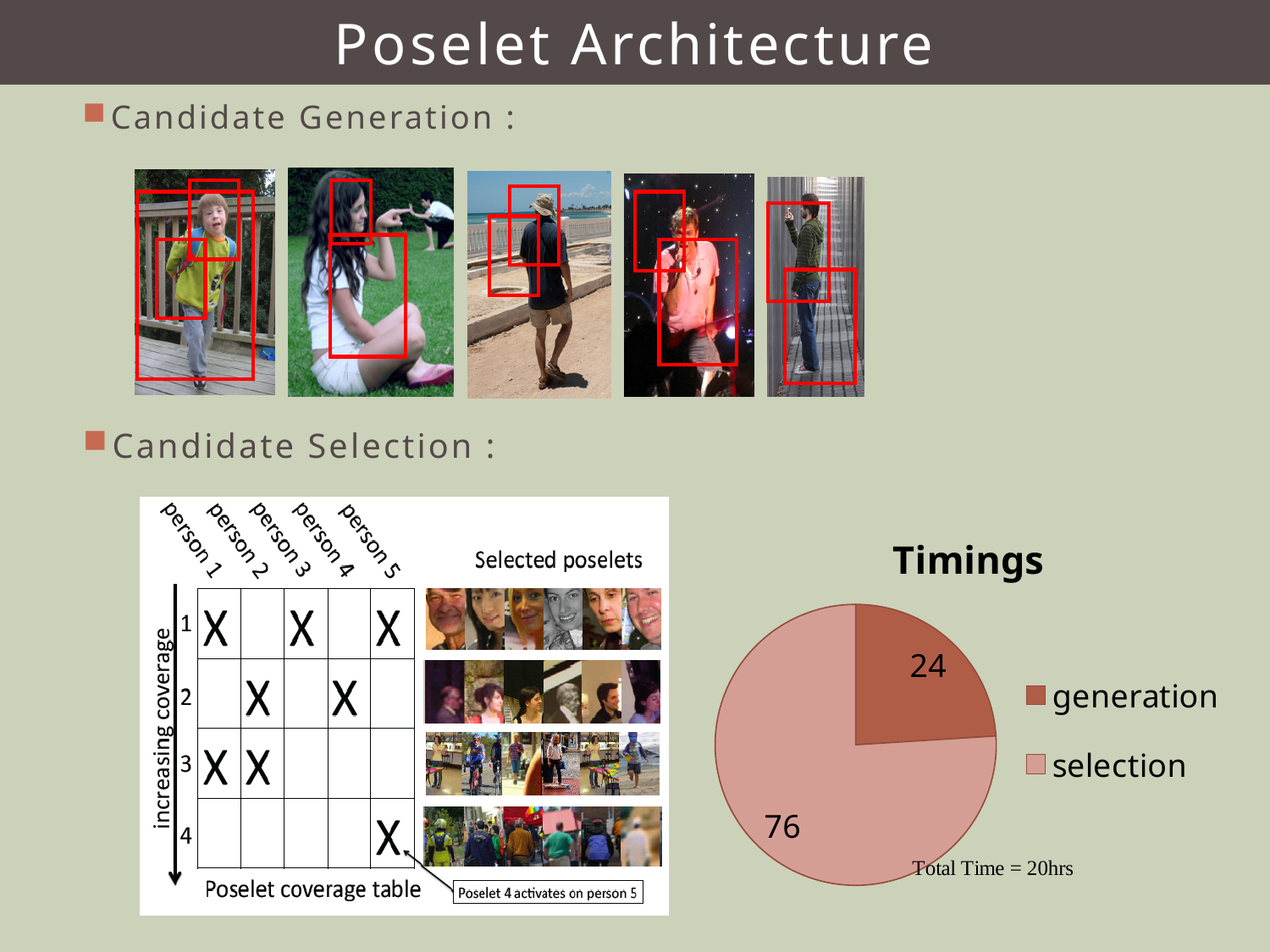
How many entries does the legend of the Timings chart list? 2 In the Timings chart, what is the value for selection? 76 What is the title of the pie chart on the slide? Timings In the Timings chart, what is the value for generation? 24 In the Timings chart, what is the difference between the selection and generation values? 52 How many slices does the Timings pie chart have? 2 What type of chart is the Timings chart? pie chart In the Timings chart, which is larger, generation or selection? selection In the Timings chart, which slice is the largest? selection In the Timings chart, what share of the pie does generation represent? 24% What total time is noted below the Timings chart? Total Time = 20hrs In the Timings chart, which slice is the smallest? generation